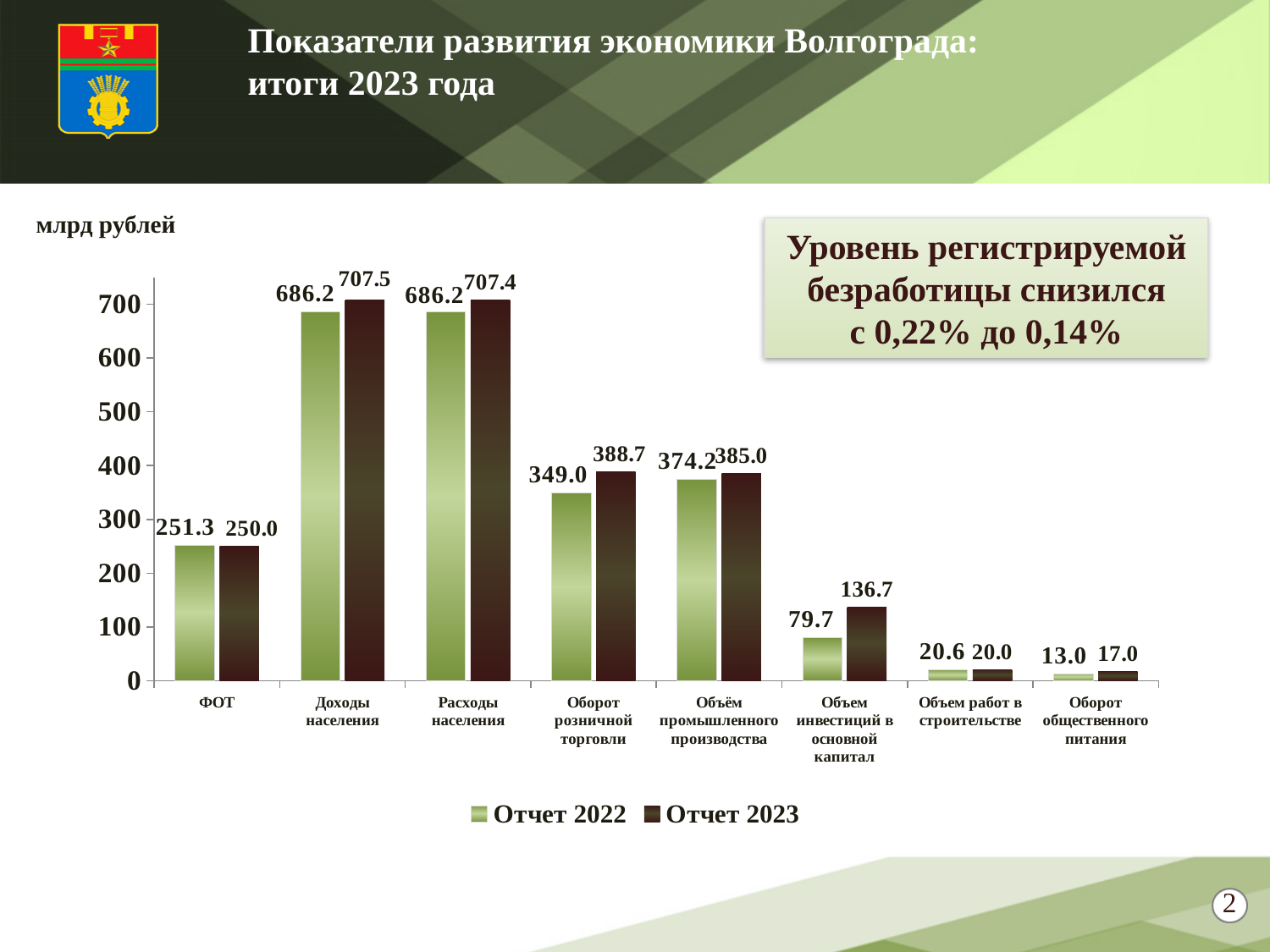
What is the value for ФОТ in the Отчет 2022 series? 251.3 What is the value for Оборот розничной торговли in the Отчет 2023 series? 388.7 What is the difference between the Отчет 2023 and Отчет 2022 values for Объем инвестиций в основной капитал? 57.0 What kind of chart is shown on the slide? bar chart Which category has the highest value in the Отчет 2023 series? Доходы населения What is the value for Объем инвестиций в основной капитал in the Отчет 2023 series? 136.7 Is the Отчет 2022 value for Оборот розничной торговли greater or less than 400? less How many series does the chart legend list? 2 Which is larger for Объём промышленного производства: the Отчет 2022 value or the Отчет 2023 value? Отчет 2023 Which category has the lowest value in the Отчет 2022 series? Оборот общественного питания What unit is indicated above the chart's vertical axis? млрд рублей How many categories are shown on the x axis of the chart? 8